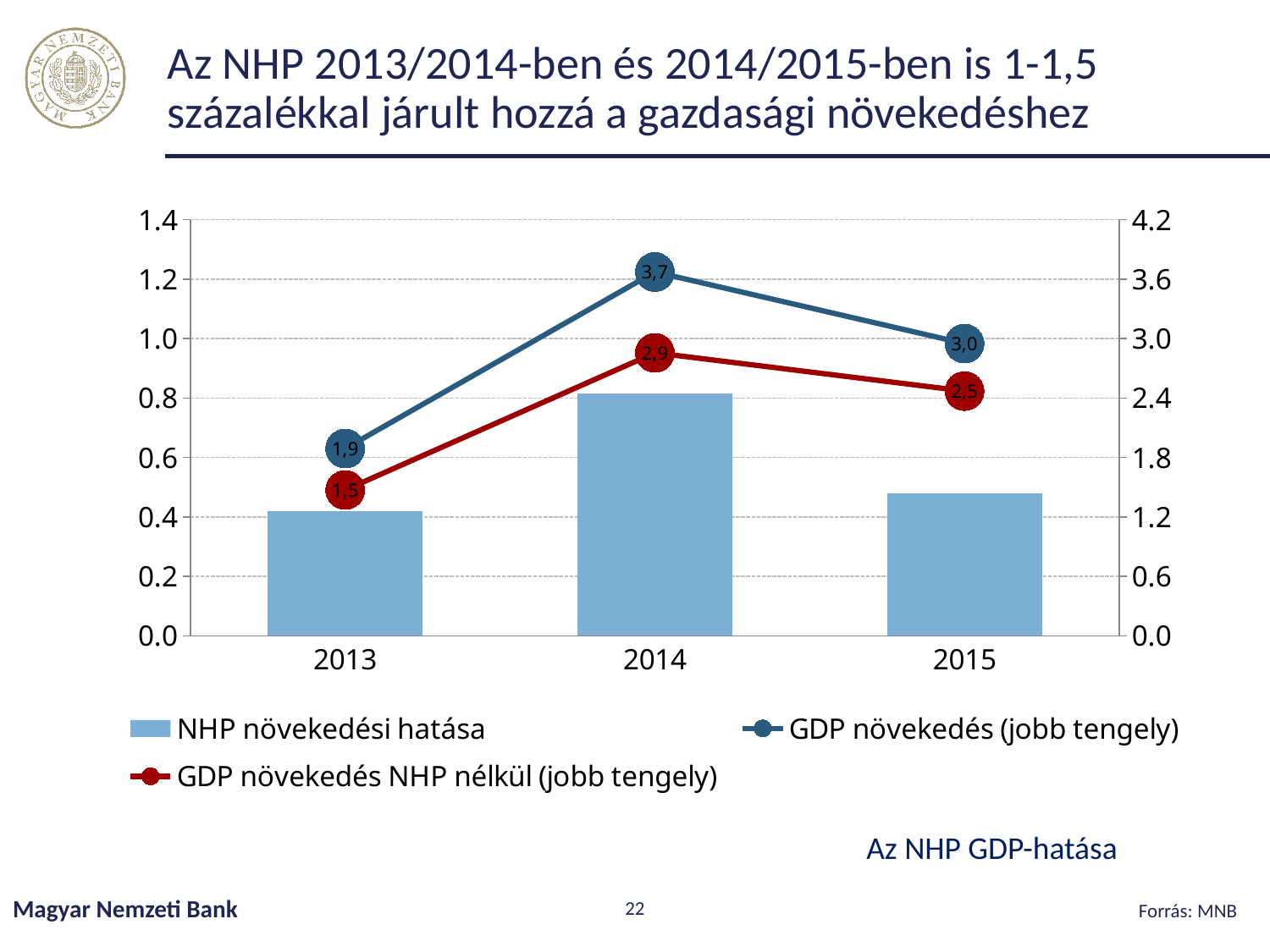
Is the NHP növekedési hatása bar for 2015 greater or less than 0.6 on the left axis? less What is the value of GDP növekedés (jobb tengely) in 2014? 3,7 Which is larger in 2015: GDP növekedés (jobb tengely) or GDP növekedés NHP nélkül (jobb tengely)? GDP növekedés (jobb tengely) In which year is GDP növekedés NHP nélkül (jobb tengely) lowest? 2013 What is the value of GDP növekedés NHP nélkül (jobb tengely) in 2013? 1,5 In which year is GDP növekedés (jobb tengely) highest? 2014 How many years are shown on the x axis? 3 How many series does the legend list? 3 What kind of chart is shown on the slide? Combined bar and line chart Is the NHP növekedési hatása bar for 2014 greater or less than 0.6 on the left axis? greater What is the difference between GDP növekedés and GDP növekedés NHP nélkül in 2014? 0,8 What is the value of GDP növekedés (jobb tengely) in 2015? 3,0